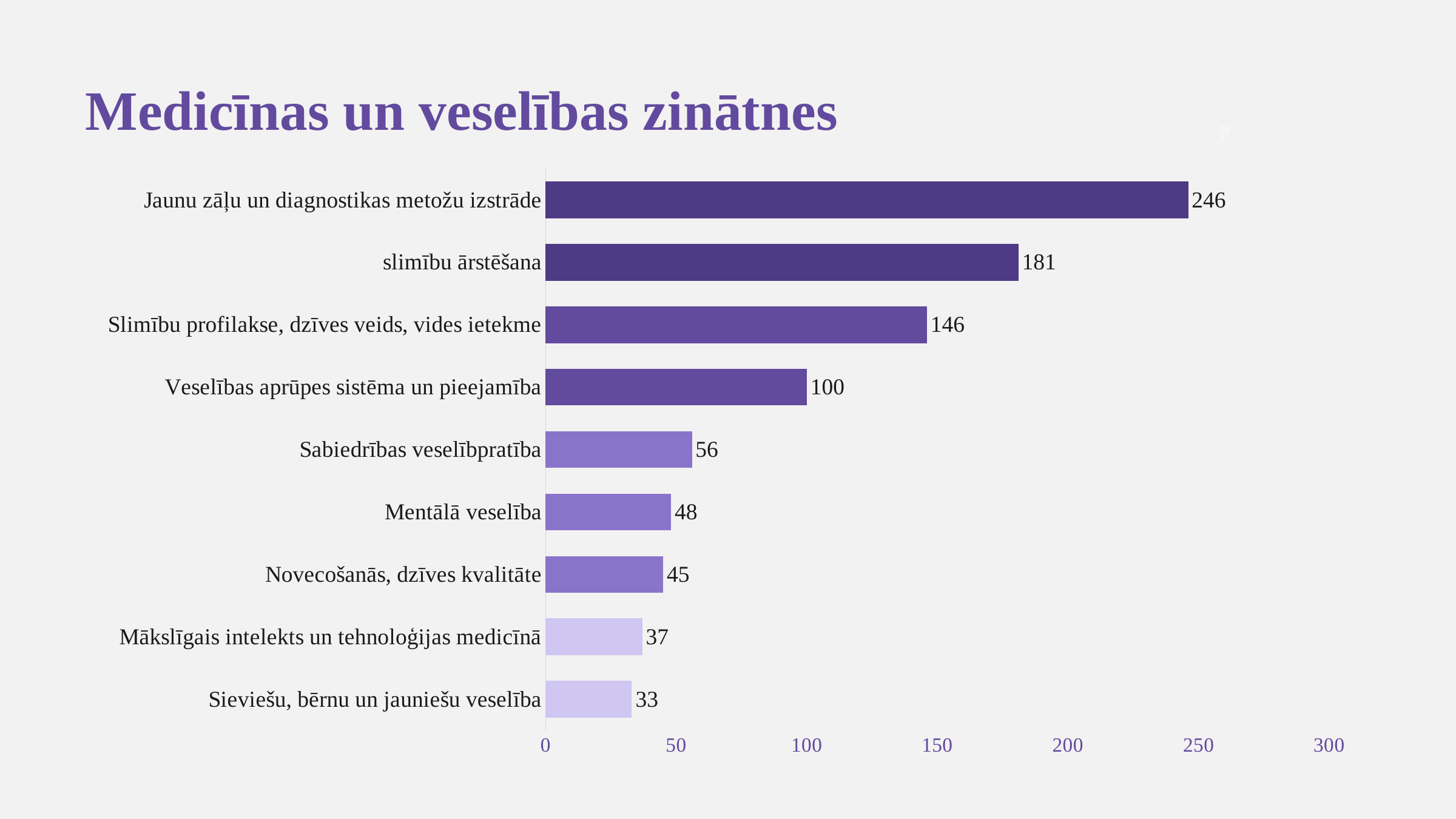
What kind of chart is shown on the slide? bar chart Which category has the lowest value? Sieviešu, bērnu un jauniešu veselība What is the difference between the values for slimību ārstēšana and Slimību profilakse, dzīves veids, vides ietekme? 35 What is the difference between the values for Sabiedrības veselībpratība and Novecošanās, dzīves kvalitāte? 11 What is the value for Jaunu zāļu un diagnostikas metožu izstrāde? 246 Which category has the highest value? Jaunu zāļu un diagnostikas metožu izstrāde How many categories are shown in the chart? 9 What is the value for Mākslīgais intelekts un tehnoloģijas medicīnā? 37 What is the title of the slide? Medicīnas un veselības zinātnes What is the value for Mentālā veselība? 48 Which is larger: the value for Veselības aprūpes sistēma un pieejamība or the value for Sabiedrības veselībpratība? Veselības aprūpes sistēma un pieejamība Is the value for slimību ārstēšana greater or less than 150? greater